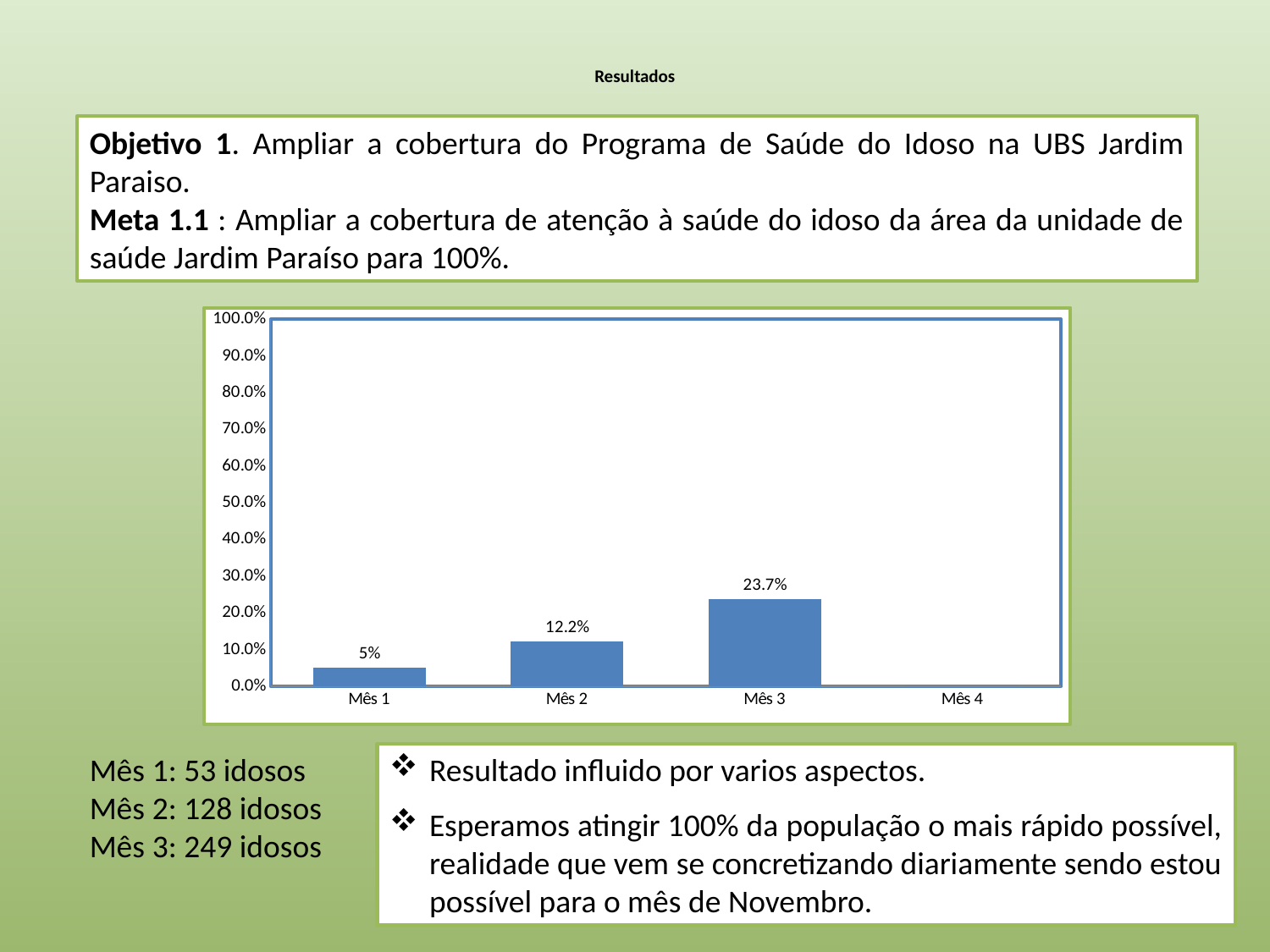
What is the value shown for Mês 3? 23.7% Among the months that have a bar plotted, which has the lowest value? Mês 1 What is the value shown for Mês 2? 12.2% Do the values rise or fall from Mês 1 to Mês 3? rise Is the value for Mês 3 greater or less than 20.0%? greater What is the value shown for Mês 1? 5% What is the difference between the values for Mês 3 and Mês 2? 11.5% What is the difference between the values for Mês 2 and Mês 1? 7.2% Which is larger, the value for Mês 2 or the value for Mês 3? Mês 3 How many month categories are shown on the x axis? 4 Which month has the highest value in the chart? Mês 3 What kind of chart is shown on the slide? bar chart